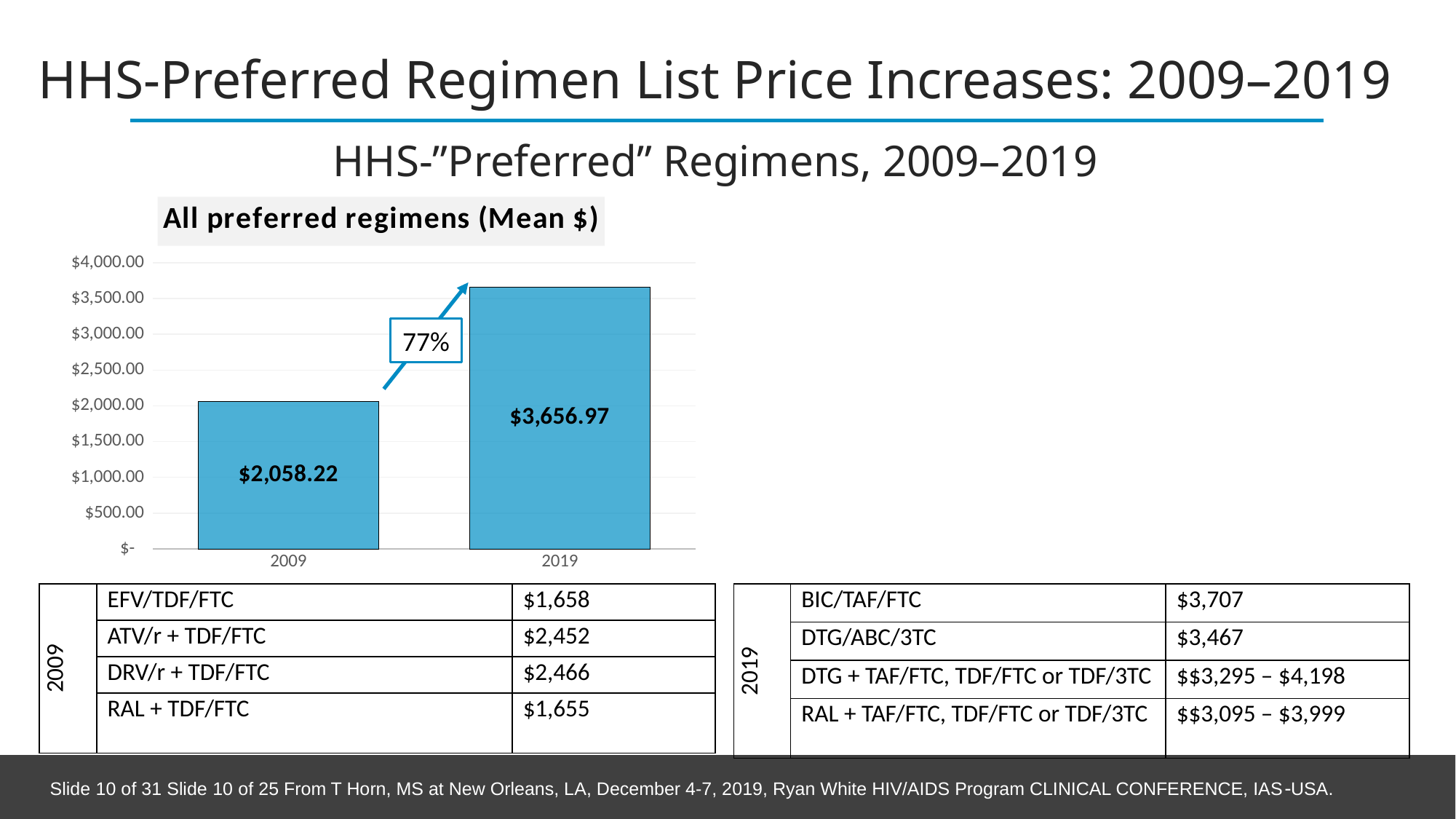
What kind of chart is shown on the slide? bar chart How many years are plotted in the chart? 2 What percentage increase is annotated between the 2009 and 2019 bars? 77% What is the mean price for all preferred regimens in 2009? $2,058.22 What is the difference between the 2019 and 2009 mean prices for all preferred regimens? $1,598.75 Which year has the higher mean price for all preferred regimens? 2019 Which year has the lower mean price for all preferred regimens? 2009 Do the mean prices rise or fall from 2009 to 2019? rise What is the title of the chart? All preferred regimens (Mean $) Is the mean price for 2019 greater or less than $3,500.00? greater What is the mean price for all preferred regimens in 2019? $3,656.97 Is the mean price for 2009 greater or less than $2,500.00? less